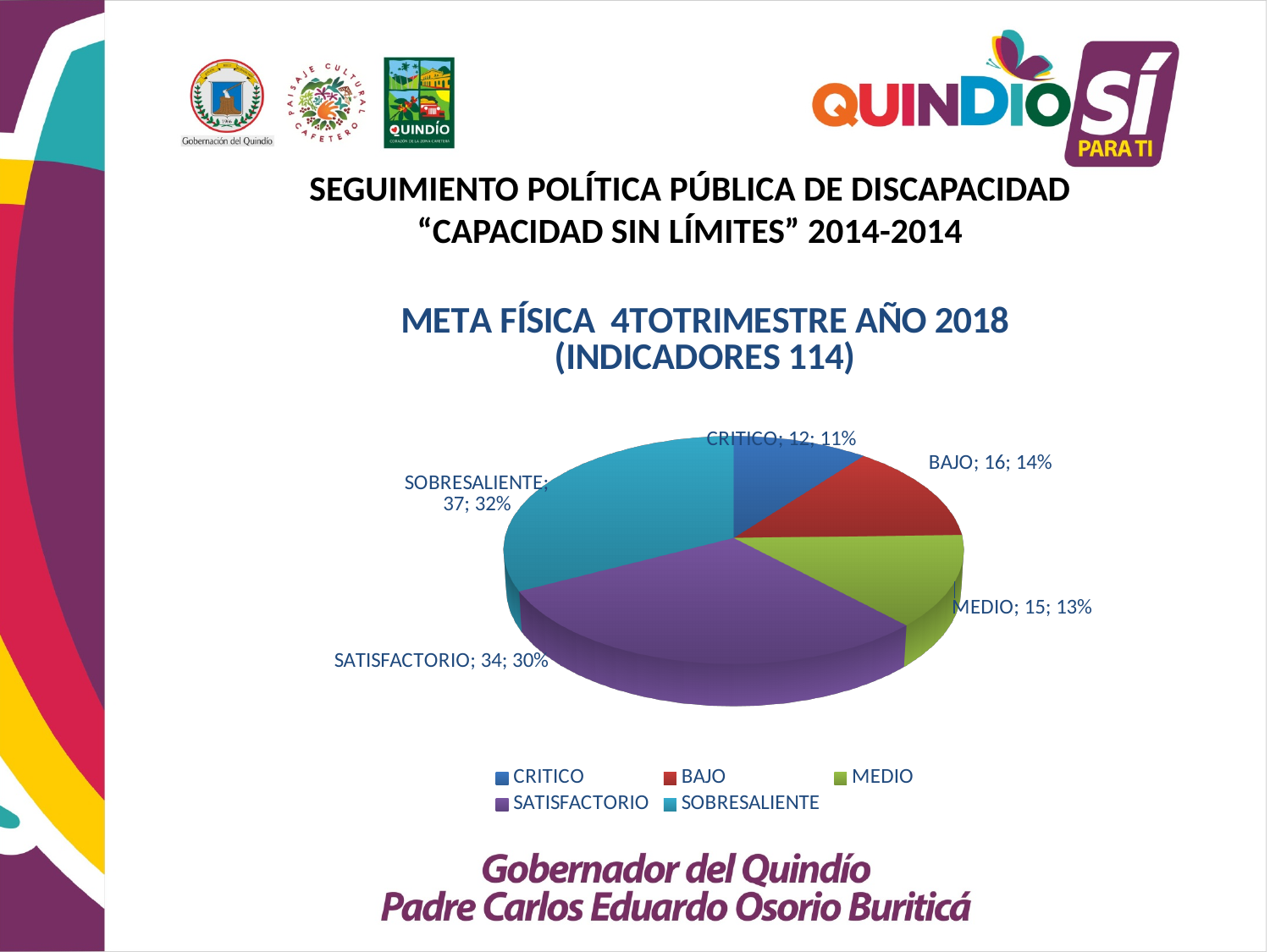
What percentage share does SATISFACTORIO have? 30% What percentage share does MEDIO have? 13% Which category has the largest value? SOBRESALIENTE What is the value for BAJO? 16 What is the difference between the values for SOBRESALIENTE and SATISFACTORIO? 3 Which is larger, the value for BAJO or the value for MEDIO? BAJO What is the value for CRITICO? 12 Which category has the smallest value? CRITICO What is the value for SOBRESALIENTE? 37 How many categories does the pie chart have? 5 What is the title of the chart? META FÍSICA 4TOTRIMESTRE AÑO 2018 (INDICADORES 114) What type of chart is shown on the slide? Pie chart